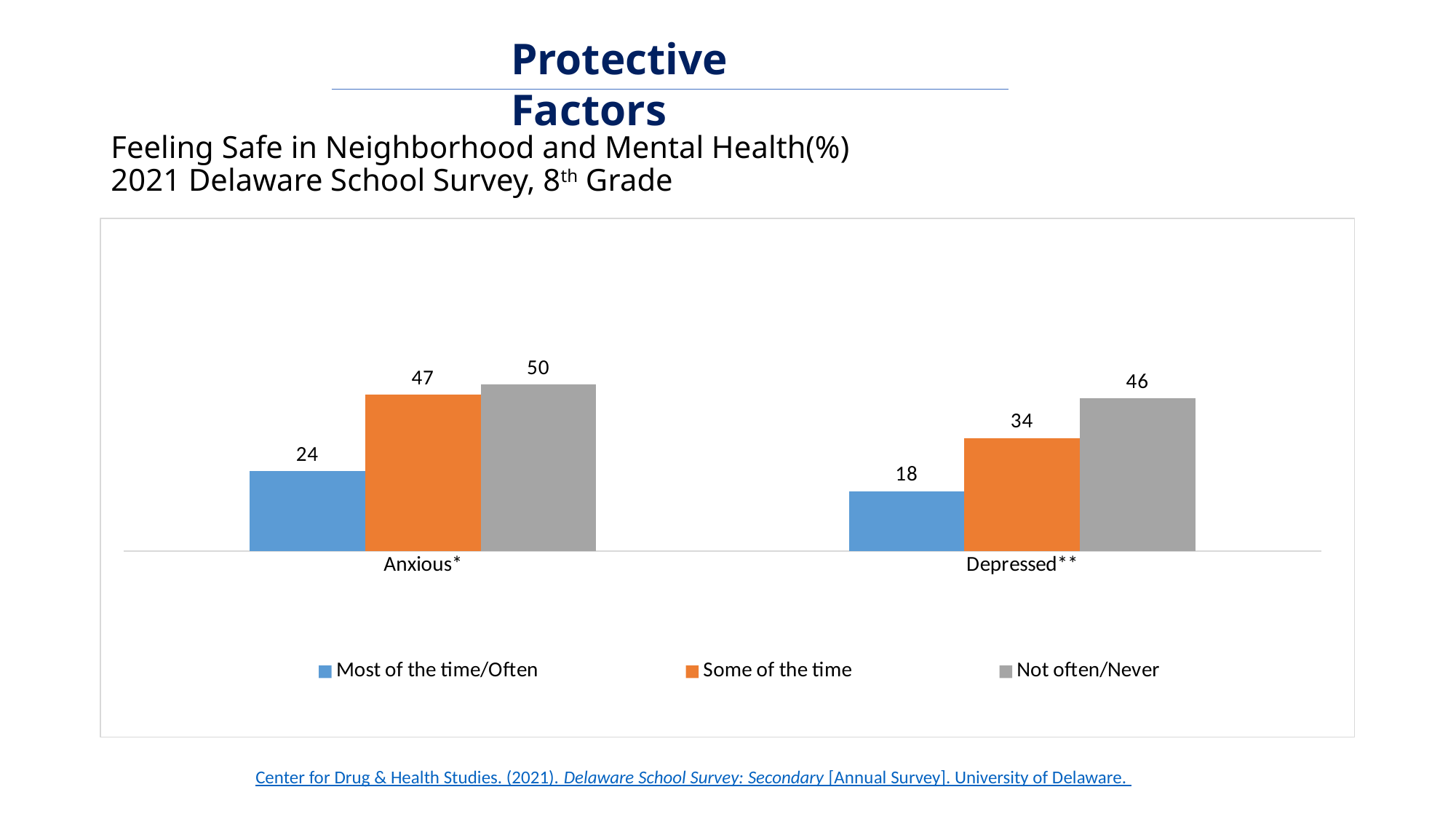
Which colour represents the 'Some of the time' series? Orange What is the value for 'Some of the time' in the Depressed** category? 34 What kind of chart is shown on the slide? Bar chart Which series has the lowest value in the Depressed** category? Most of the time/Often Which is larger: the 'Some of the time' value for Anxious* or the 'Not often/Never' value for Depressed**? Some of the time for Anxious* What is the value for 'Most of the time/Often' in the Anxious* category? 24 What is the difference between the 'Some of the time' values for Anxious* and Depressed**? 13 Which series has the highest value in the Anxious* category? Not often/Never How many categories are shown on the x axis? 2 How many series does the legend list? 3 What is the difference between the 'Not often/Never' and 'Most of the time/Often' values in the Anxious* category? 26 What is the value for 'Not often/Never' in the Depressed** category? 46